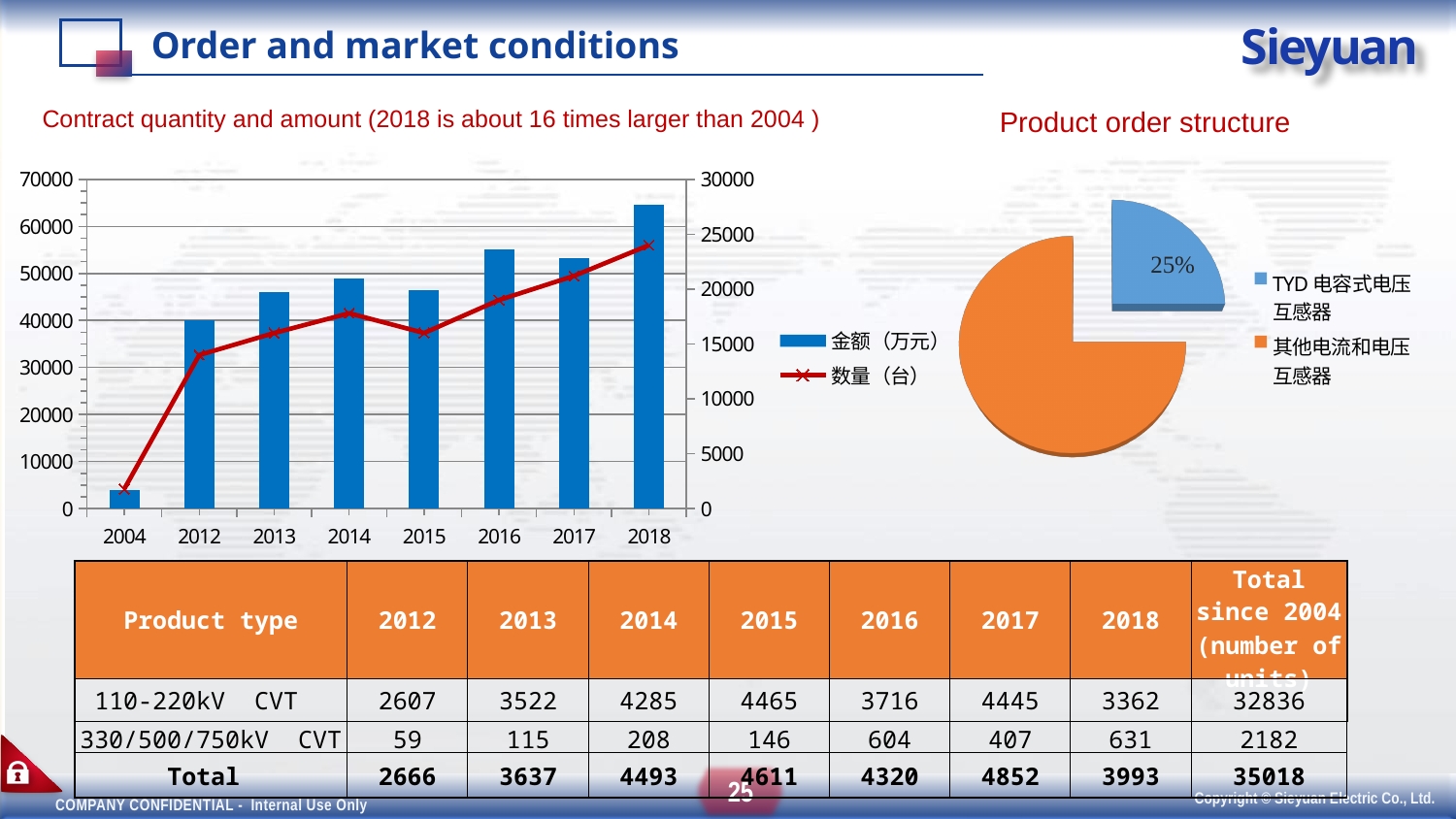
In the 'Contract quantity and amount' chart, is the 金额（万元） bar for 2018 greater or less than 60000? greater In the 'Contract quantity and amount' chart, which year has the larger 金额（万元） bar, 2015 or 2016? 2016 In the 'Contract quantity and amount' chart, how many series does the legend list? 2 In the 'Contract quantity and amount' chart, is the 数量（台） value for 2018 greater or less than 20000 on the right axis? greater In the 'Contract quantity and amount' chart, how many years are shown on the x axis? 8 What kind of chart is the 'Product order structure' chart? pie chart In the 'Contract quantity and amount' chart, which year has the shortest 金额（万元） bar? 2004 In the 'Contract quantity and amount' chart, is the 金额（万元） bar for 2004 greater or less than 10000? less In the 'Contract quantity and amount' chart, does the 数量（台） line generally rise or fall from 2004 to 2018? rise In the 'Product order structure' chart, what share of the pie is TYD 电容式电压互感器? 25% In the 'Product order structure' chart, which slice is larger, TYD 电容式电压互感器 or 其他电流和电压互感器? 其他电流和电压互感器 In the 'Contract quantity and amount' chart, which year has the tallest 金额（万元） bar? 2018